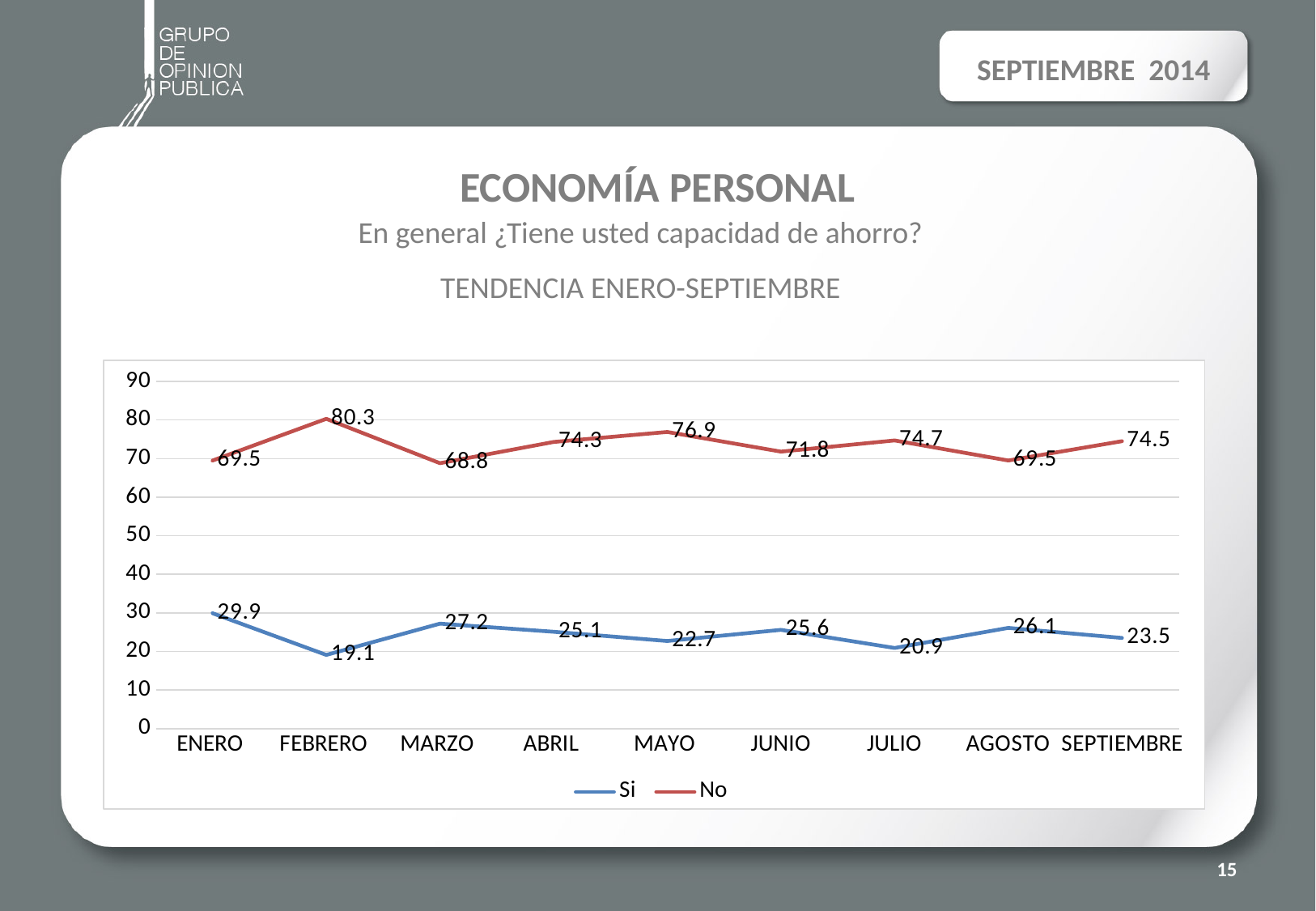
How many series does the legend list? 2 Is the 'No' value for MARZO greater or less than 70? less What is the difference between the 'No' and 'Si' values for ENERO? 39.6 How many months are shown on the x axis? 9 In which month is the 'No' series highest? FEBRERO Which is larger: the 'Si' value for MARZO or the 'Si' value for JULIO? MARZO What is the value of the 'Si' series for MAYO? 22.7 In which month is the 'Si' series lowest? FEBRERO What kind of chart is shown on the slide? line chart What is the value of the 'No' series for FEBRERO? 80.3 In which month is the 'Si' series highest? ENERO What is the value of the 'Si' series for SEPTIEMBRE? 23.5